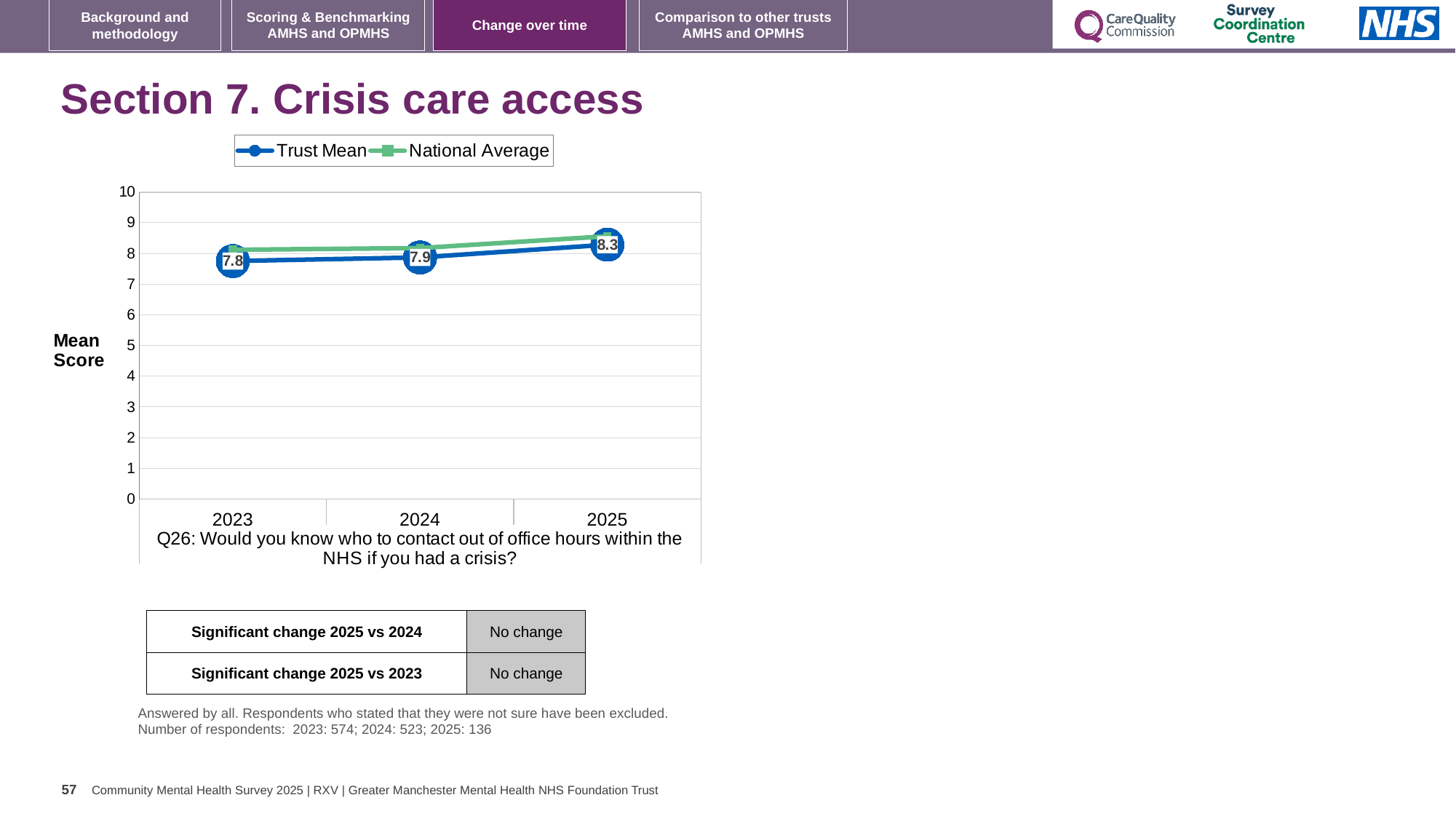
How many years are plotted on the x axis? 3 Is the Trust Mean score higher in 2025 or in 2024? 2025 What is the difference between the Trust Mean score in 2025 and in 2024? 0.4 What is the difference between the Trust Mean score in 2025 and in 2023? 0.5 How many series does the legend list? 2 What is the Trust Mean score for 2023? 7.8 In which year is the Trust Mean score lowest? 2023 What is the Trust Mean score for 2025? 8.3 Is the National Average value for 2025 greater or less than 8? greater What is the Trust Mean score for 2024? 7.9 What kind of chart is shown on the slide? Line chart In which year is the Trust Mean score highest? 2025